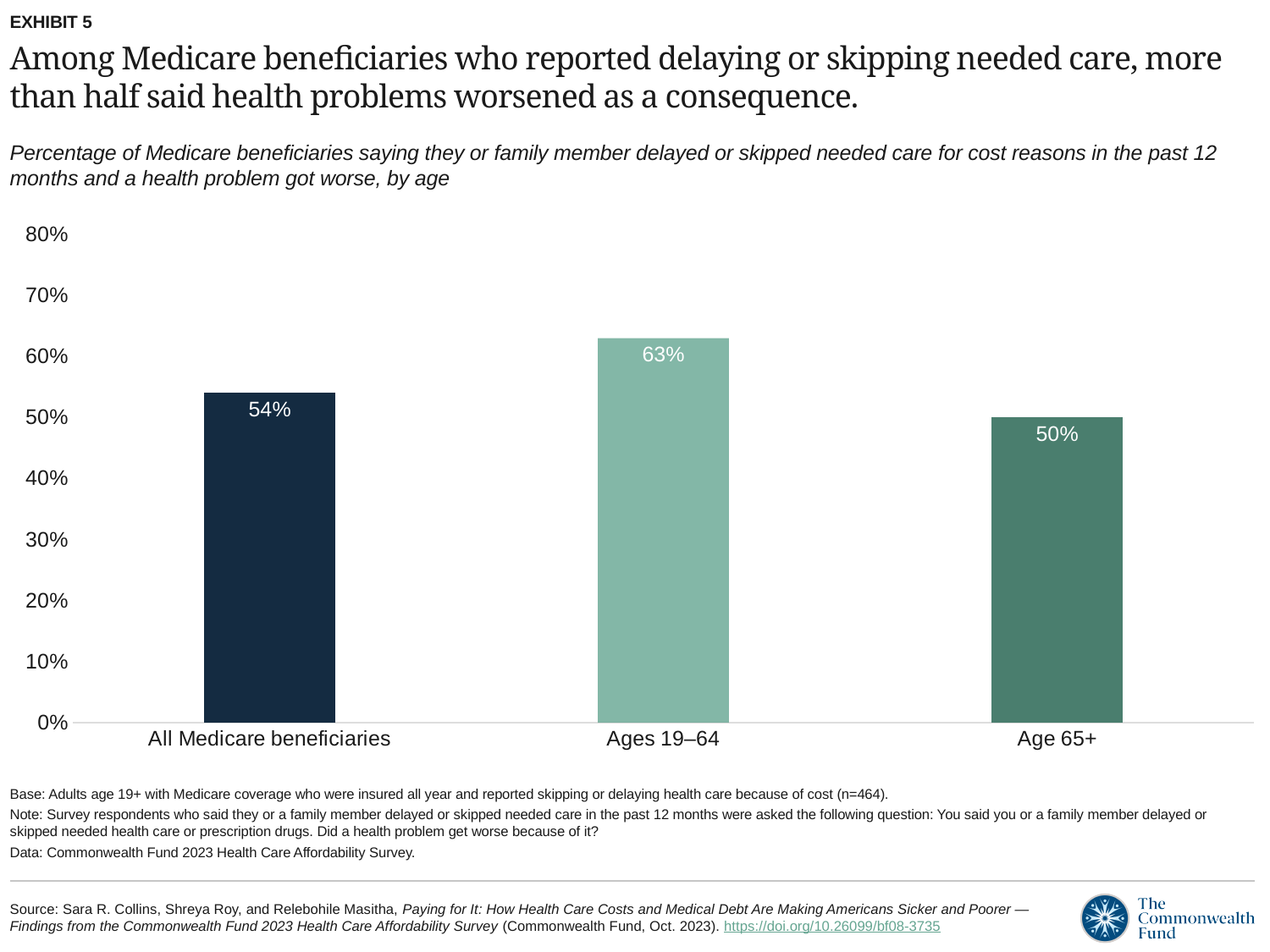
What is the difference in percentage points between Ages 19–64 and Age 65+? 13 percentage points What is the highest value shown on the y axis? 80% Which age group has the highest percentage? Ages 19–64 What percentage is shown for Age 65+? 50% How many categories are shown on the x axis? 3 Is the value for Ages 19–64 greater or less than 60%? greater Which is larger, the value for All Medicare beneficiaries or the value for Age 65+? All Medicare beneficiaries Which category has the lowest percentage? Age 65+ What percentage is shown for All Medicare beneficiaries? 54% What percentage is shown for Ages 19–64? 63% What is the difference in percentage points between Ages 19–64 and All Medicare beneficiaries? 9 percentage points What kind of chart is shown on the slide? Bar chart